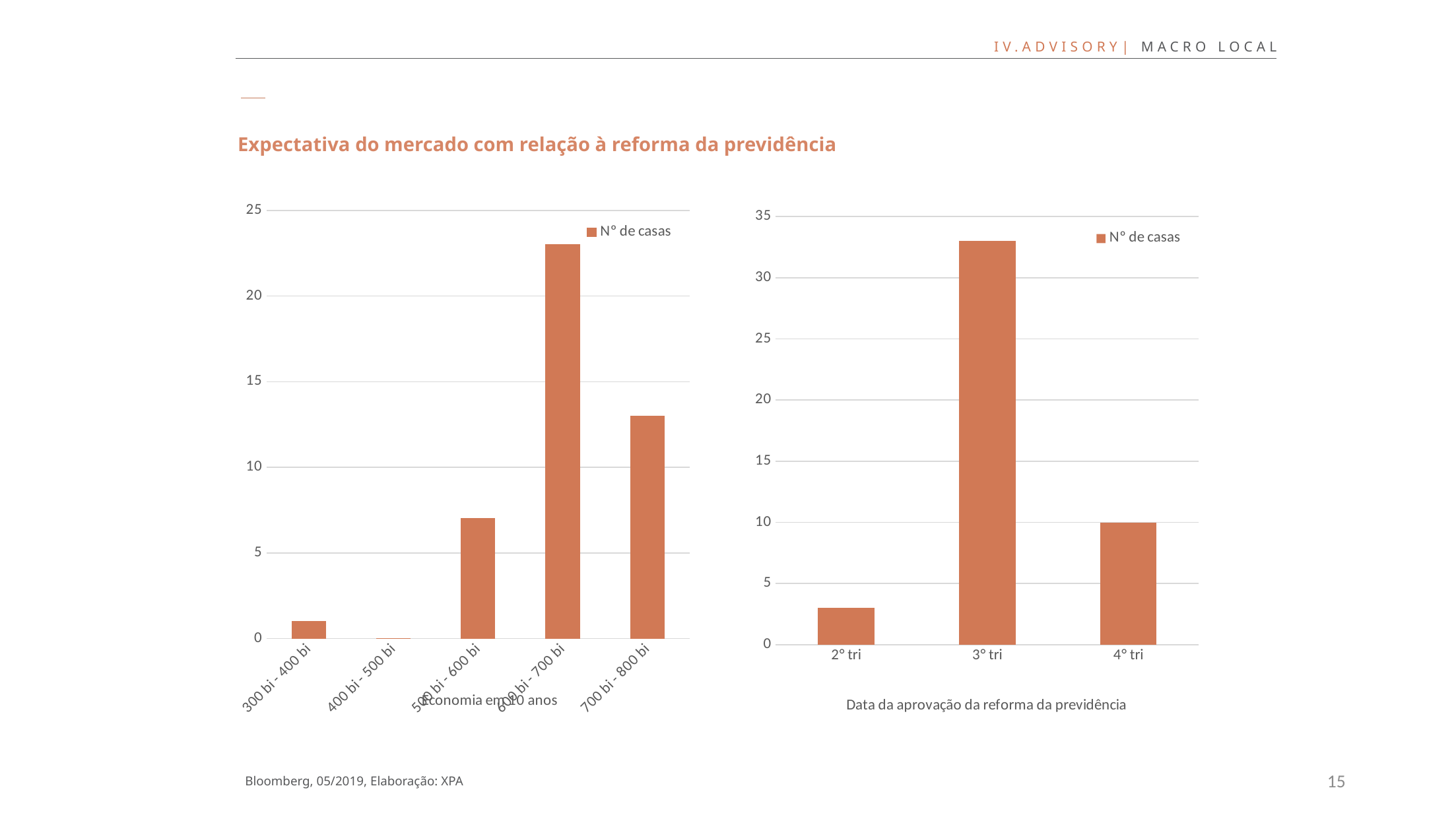
What type of chart is the right chart (Data da aprovação da reforma da previdência)? bar chart In the right chart (Data da aprovação da reforma da previdência), which category has the lowest value? 2° tri In the left chart (Economia em 10 anos), which category has the lowest value? 400 bi - 500 bi In the right chart (Data da aprovação da reforma da previdência), which category has the highest value? 3° tri In the left chart (Economia em 10 anos), is the value for 600 bi - 700 bi greater or less than 20? greater How many categories are shown on the x axis of the left chart (Economia em 10 anos)? 5 In the left chart (Economia em 10 anos), is the value for 700 bi - 800 bi greater or less than 15? less In the left chart (Economia em 10 anos), is the value for 500 bi - 600 bi greater or less than 5? greater In the left chart (Economia em 10 anos), which is larger, the value for 500 bi - 600 bi or the value for 700 bi - 800 bi? 700 bi - 800 bi In the left chart (Economia em 10 anos), which category has the highest value? 600 bi - 700 bi What series name does the legend of the left chart (Economia em 10 anos) show? N° de casas